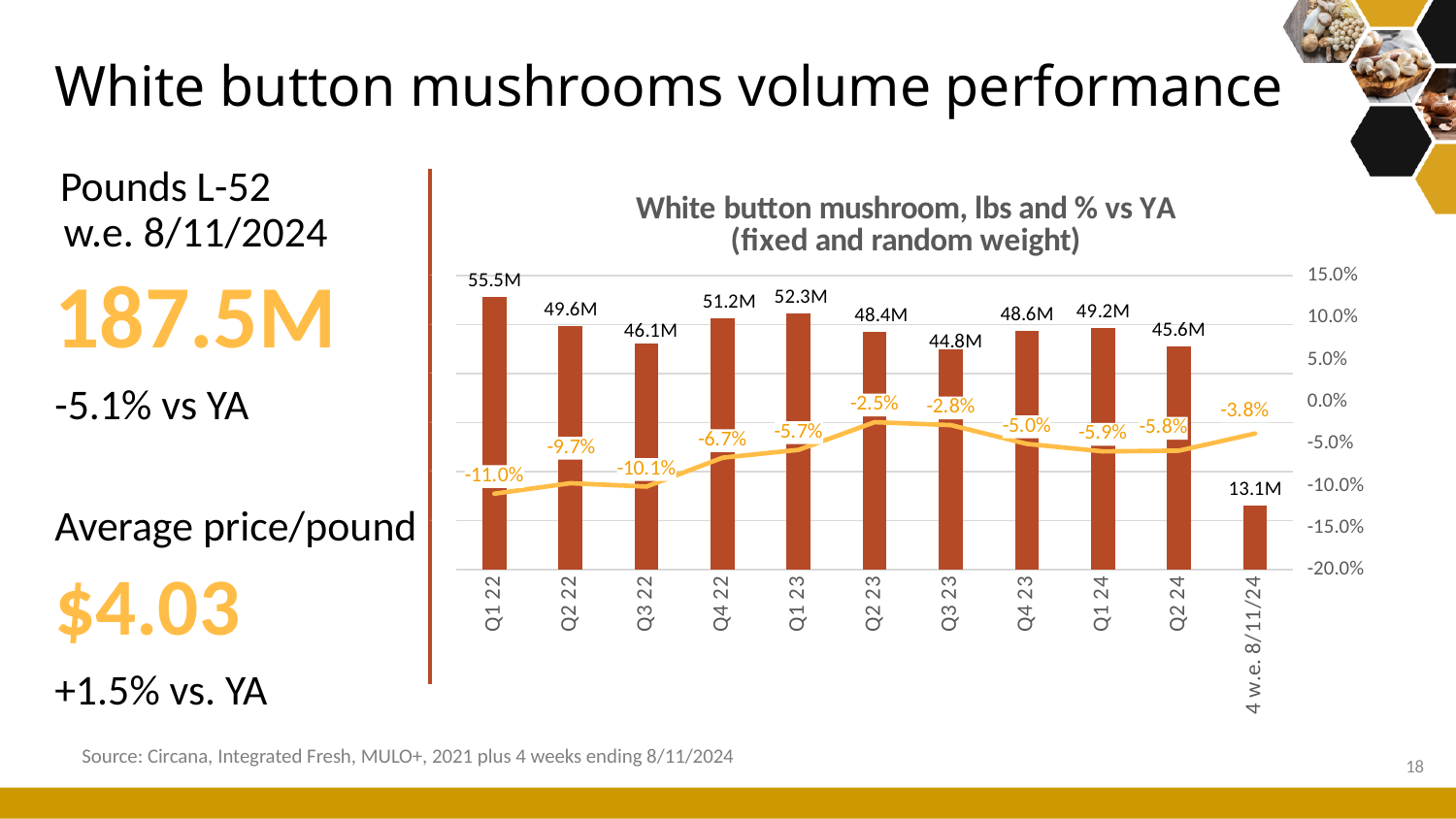
How many periods are shown on the x axis of the chart? 11 Which has the larger volume in pounds, Q4 22 or Q2 24? Q4 22 Which quarter has the highest volume in pounds? Q1 22 What kind of chart is used to show the pounds values? Bar chart What is the volume in pounds for Q1 22? 55.5M What is the % vs YA value for Q2 23? -2.5% What is the title of the chart? White button mushroom, lbs and % vs YA (fixed and random weight) Does the % vs YA line rise or fall from Q1 22 to Q2 23? Rise Which period has the lowest % vs YA value? Q1 22 What is the % vs YA value for Q2 24? -5.8% What is the difference in pounds between Q1 23 and Q3 23? 7.5M What is the volume in pounds for the 4 w.e. 8/11/24 period? 13.1M